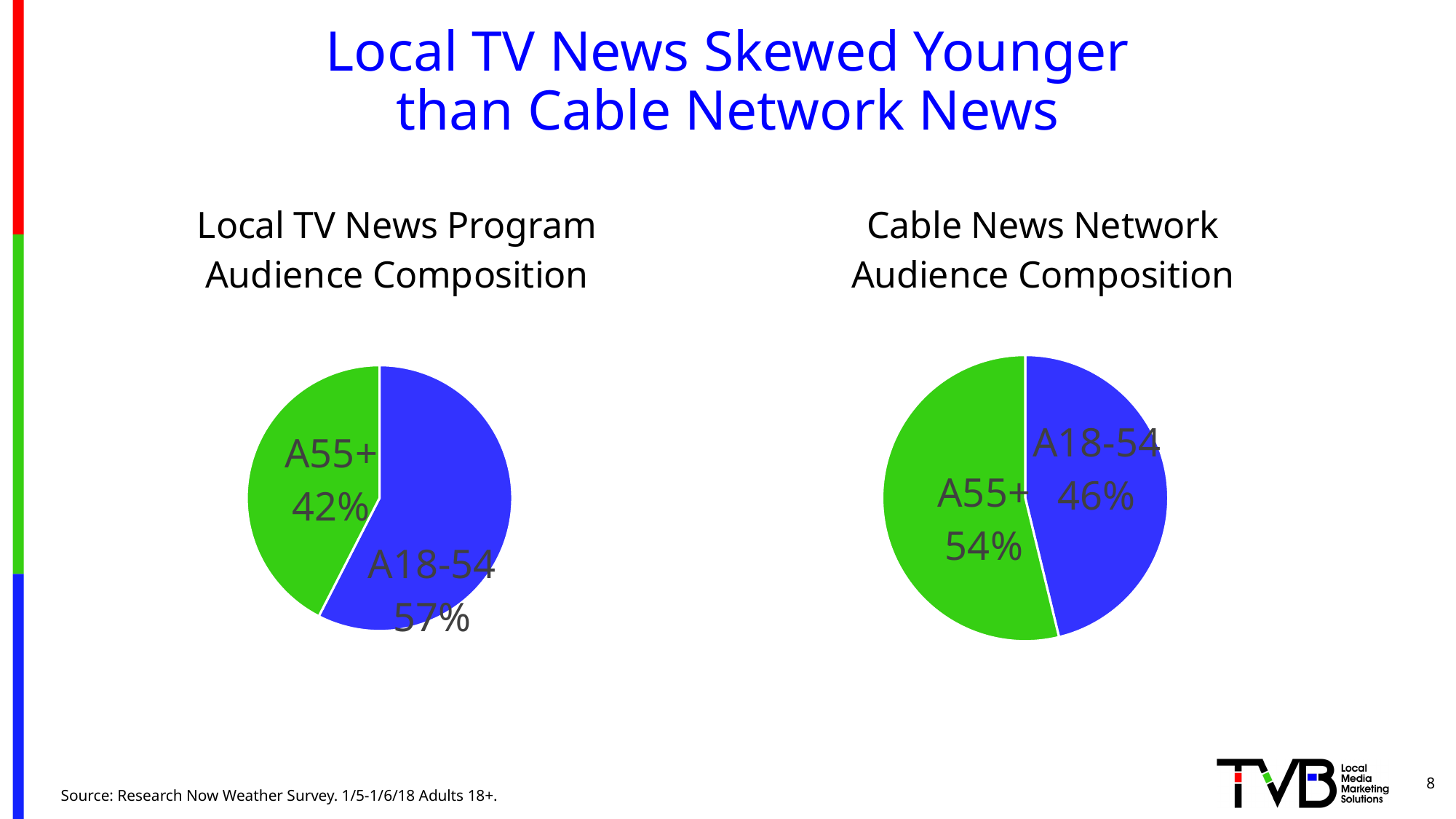
In the Local TV News Program Audience Composition chart, what share of the audience is A18-54? 57% In the Cable News Network Audience Composition chart, what share of the audience is A55+? 54% Which chart shows a larger A18-54 share, the Local TV News Program chart or the Cable News Network chart? Local TV News Program In the Local TV News Program Audience Composition chart, what is the difference in percentage points between the A18-54 and A55+ slices? 15 In the Cable News Network Audience Composition chart, what share of the audience is A18-54? 46% In the Local TV News Program Audience Composition chart, what share of the audience is A55+? 42% How many slices does the Cable News Network Audience Composition pie chart have? 2 In the Cable News Network Audience Composition chart, which age group has the smaller slice? A18-54 In the Local TV News Program Audience Composition chart, what colour is the A55+ slice? Green In the Cable News Network Audience Composition chart, what is the difference in percentage points between the A55+ and A18-54 slices? 8 In the Local TV News Program Audience Composition chart, which age group has the larger slice? A18-54 What type of chart is used for the Local TV News Program Audience Composition? Pie chart